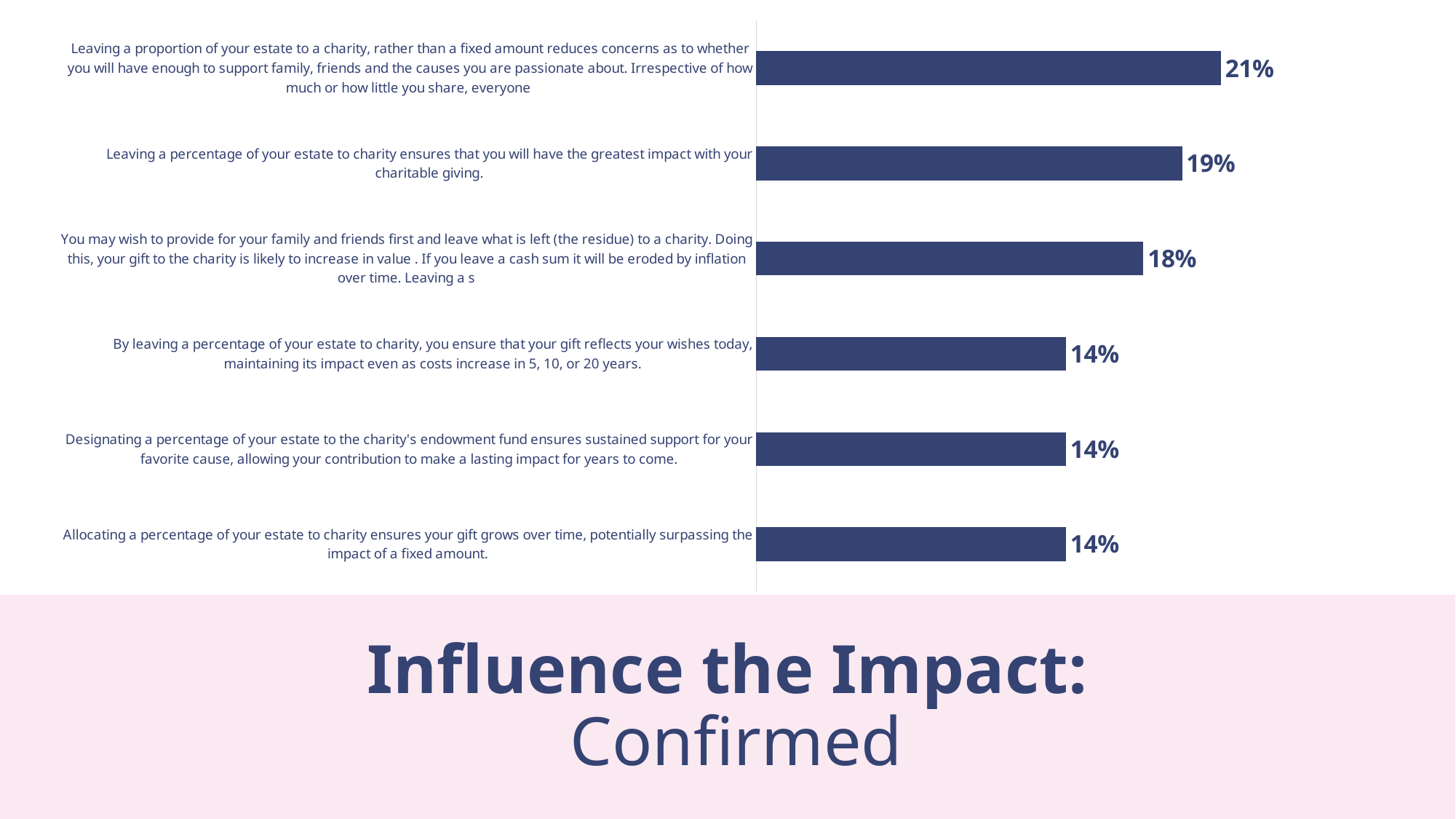
How many bars does the chart show? 6 What is the value for the statement "Leaving a percentage of your estate to charity ensures that you will have the greatest impact with your charitable giving."? 19% What kind of chart is shown on the slide? bar chart What is the difference between the highest value (21%) and the value for the statement beginning "By leaving a percentage of your estate to charity, you ensure that your gift reflects your wishes today"? 7% What is the value for the statement beginning "You may wish to provide for your family and friends first and leave what is left (the residue) to a charity"? 18% What is the value for the statement beginning "Designating a percentage of your estate to the charity's endowment fund"? 14% Which statement has the highest value? Leaving a proportion of your estate to a charity, rather than a fixed amount reduces concerns as to whether you will have enough to support family, friends and the causes you are passionate about. What is the title text shown below the chart? Influence the Impact: Confirmed Which is larger: the value for the statement beginning "Leaving a percentage of your estate to charity ensures that you will have the greatest impact" or the value for the statement beginning "You may wish to provide for your family and friends first"? Leaving a percentage of your estate to charity ensures that you will have the greatest impact with your charitable giving. What is the value for the statement beginning "Leaving a proportion of your estate to a charity, rather than a fixed amount"? 21% How many bars share the value 14%? 3 What is the lowest value shown on the chart? 14%